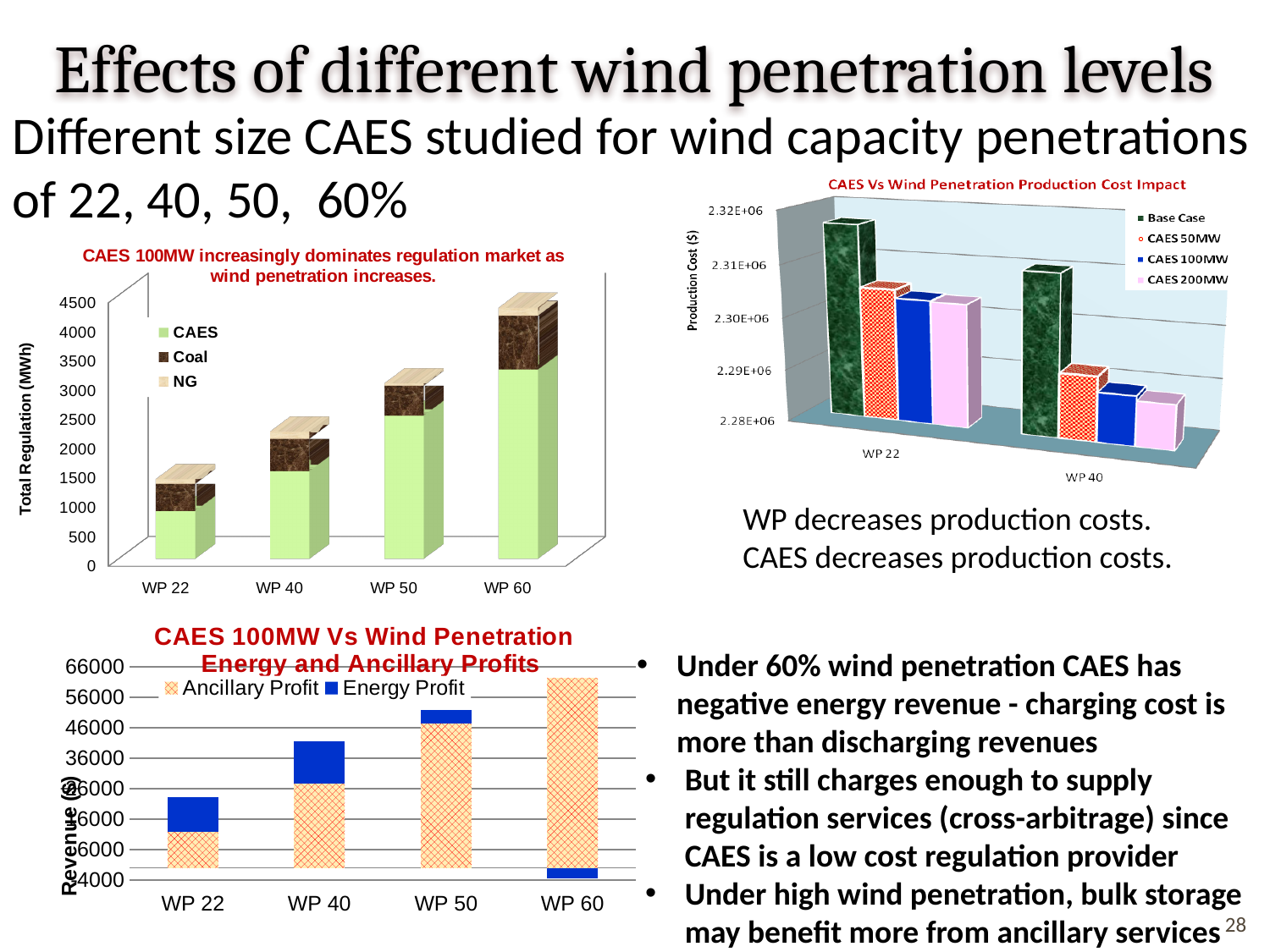
In the bottom-left chart 'CAES 100MW Vs Wind Penetration Energy and Ancillary Profits', how many series does the legend list? 2 In the top-left chart (Total Regulation), is the CAES value for WP 60 greater or less than 3000? greater In the top-right chart 'CAES Vs Wind Penetration Production Cost Impact', how many series does the legend list? 4 In the top-right chart 'CAES Vs Wind Penetration Production Cost Impact', how many wind penetration categories are shown on the x axis? 2 In the top-right chart 'CAES Vs Wind Penetration Production Cost Impact', which series has the highest production cost at WP 22? Base Case In the bottom-left chart 'CAES 100MW Vs Wind Penetration Energy and Ancillary Profits', which wind penetration level has the highest Ancillary Profit? WP 60 In the top-left chart (Total Regulation), which wind penetration level has the highest total regulation? WP 60 What type of chart is the top-left chart titled 'CAES 100MW increasingly dominates regulation market as wind penetration increases'? Stacked bar chart In the top-right chart 'CAES Vs Wind Penetration Production Cost Impact', is the Base Case production cost larger at WP 22 or at WP 40? WP 22 In the top-left chart (Total Regulation), how many series does the legend list? 3 In the top-left chart (Total Regulation), does total regulation rise or fall as wind penetration increases from WP 22 to WP 60? Rises In the bottom-left chart 'CAES 100MW Vs Wind Penetration Energy and Ancillary Profits', is the Energy Profit larger at WP 40 or at WP 50? WP 40